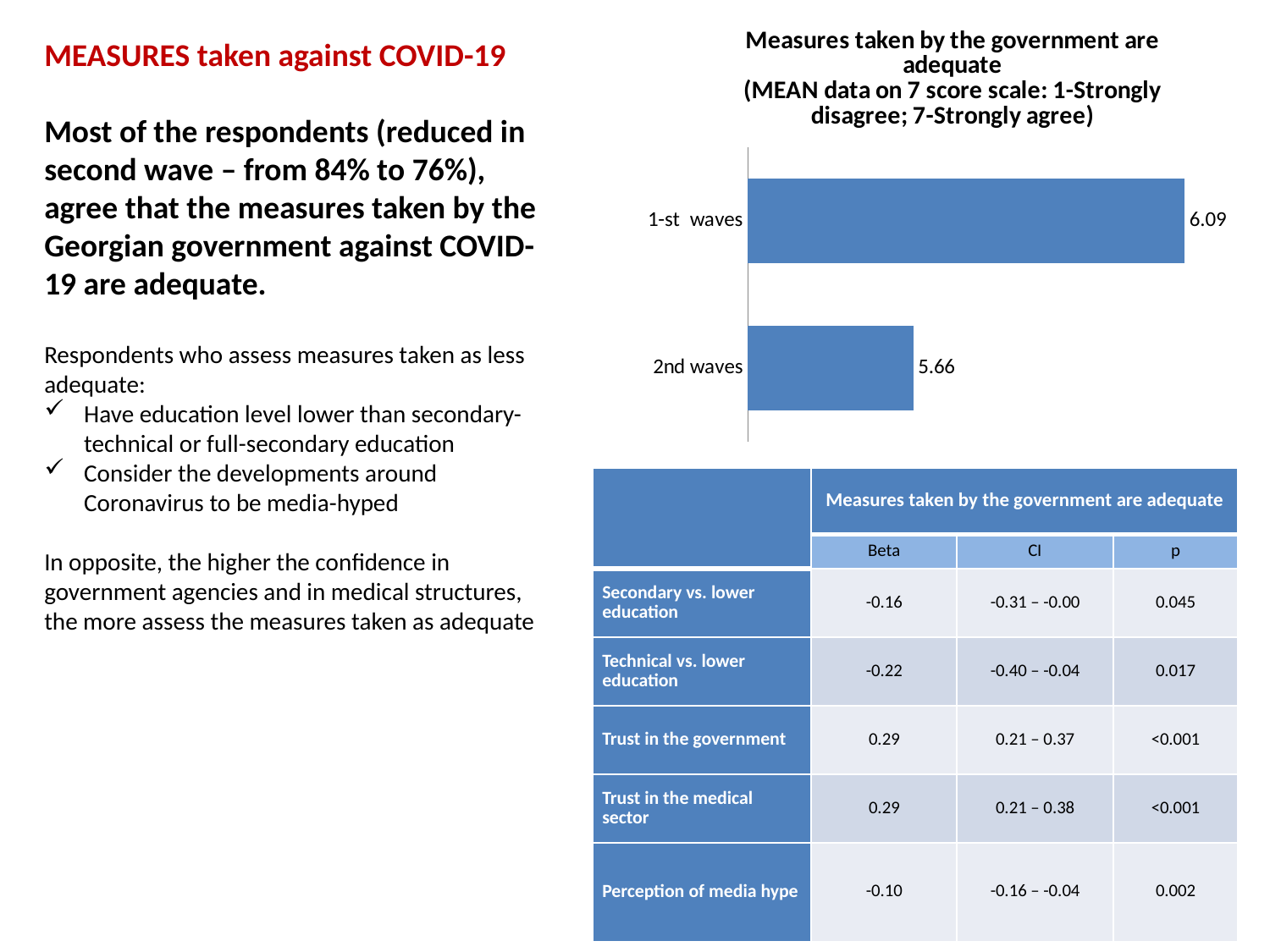
What colour are the bars in the chart? Blue What is the mean value for 2nd waves in the chart? 5.66 What kind of chart is shown on the slide? Bar chart Which is larger, the value for 1-st waves or for 2nd waves? 1-st waves What scale does the chart title say the mean data is based on? 7 score scale: 1-Strongly disagree; 7-Strongly agree What is the mean value for 1-st waves in the chart? 6.09 Which category has the lowest value in the chart? 2nd waves Does the mean value rise or fall from the 1-st waves to the 2nd waves? Fall What is the difference between the values for 1-st waves and 2nd waves? 0.43 Which category has the highest value in the chart? 1-st waves How many categories are shown in the chart? 2